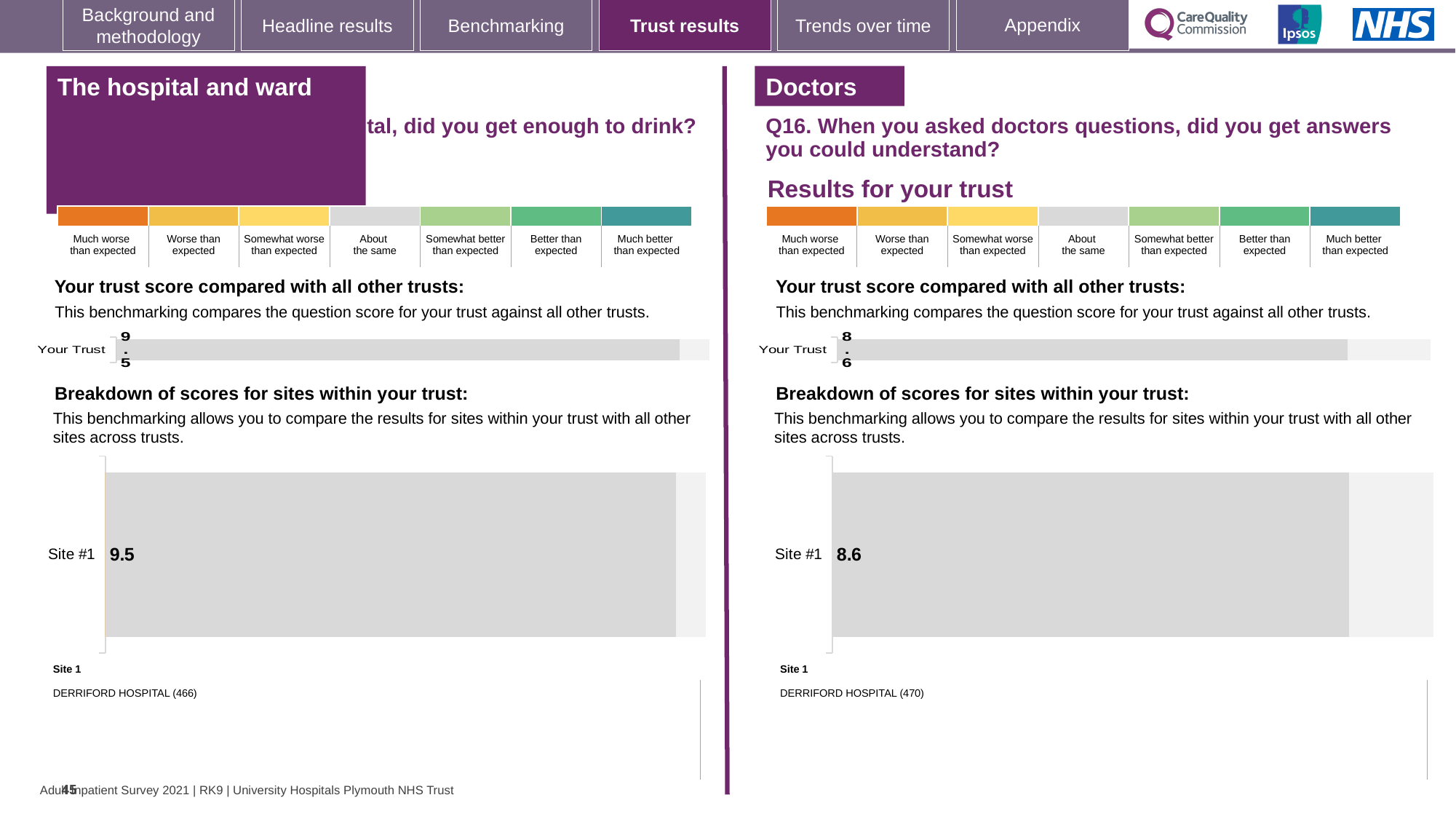
On the left half of the slide, what is the value shown for Your Trust in the 'Your trust score compared with all other trusts' chart? 9.5 How many sites are plotted in the left 'Breakdown of scores for sites within your trust' chart? 1 Which site is listed as Site 1 below the right (Q16) breakdown chart? DERRIFORD HOSPITAL (470) What is the category label on the bar in the left 'Your trust score compared with all other trusts' chart? Your Trust On the right half of the slide (Q16, Doctors), what is the value shown for Your Trust in the 'Your trust score compared with all other trusts' chart? 8.6 What kind of chart is used to show the Site #1 score in the left 'Breakdown of scores for sites within your trust' section? Bar chart How many sites are plotted in the right (Q16) 'Breakdown of scores for sites within your trust' chart? 1 In the left 'Breakdown of scores for sites within your trust' chart, what is the value for Site #1? 9.5 In the right 'Breakdown of scores for sites within your trust' chart (Q16), what is the value for Site #1? 8.6 Which site is listed as Site 1 below the left breakdown chart? DERRIFORD HOSPITAL (466) What is the difference between the Site #1 score in the left breakdown chart and the Site #1 score in the right (Q16) breakdown chart? 0.9 Which is larger: the Your Trust score in the left chart or the Your Trust score in the right (Q16) chart? The left chart (9.5)